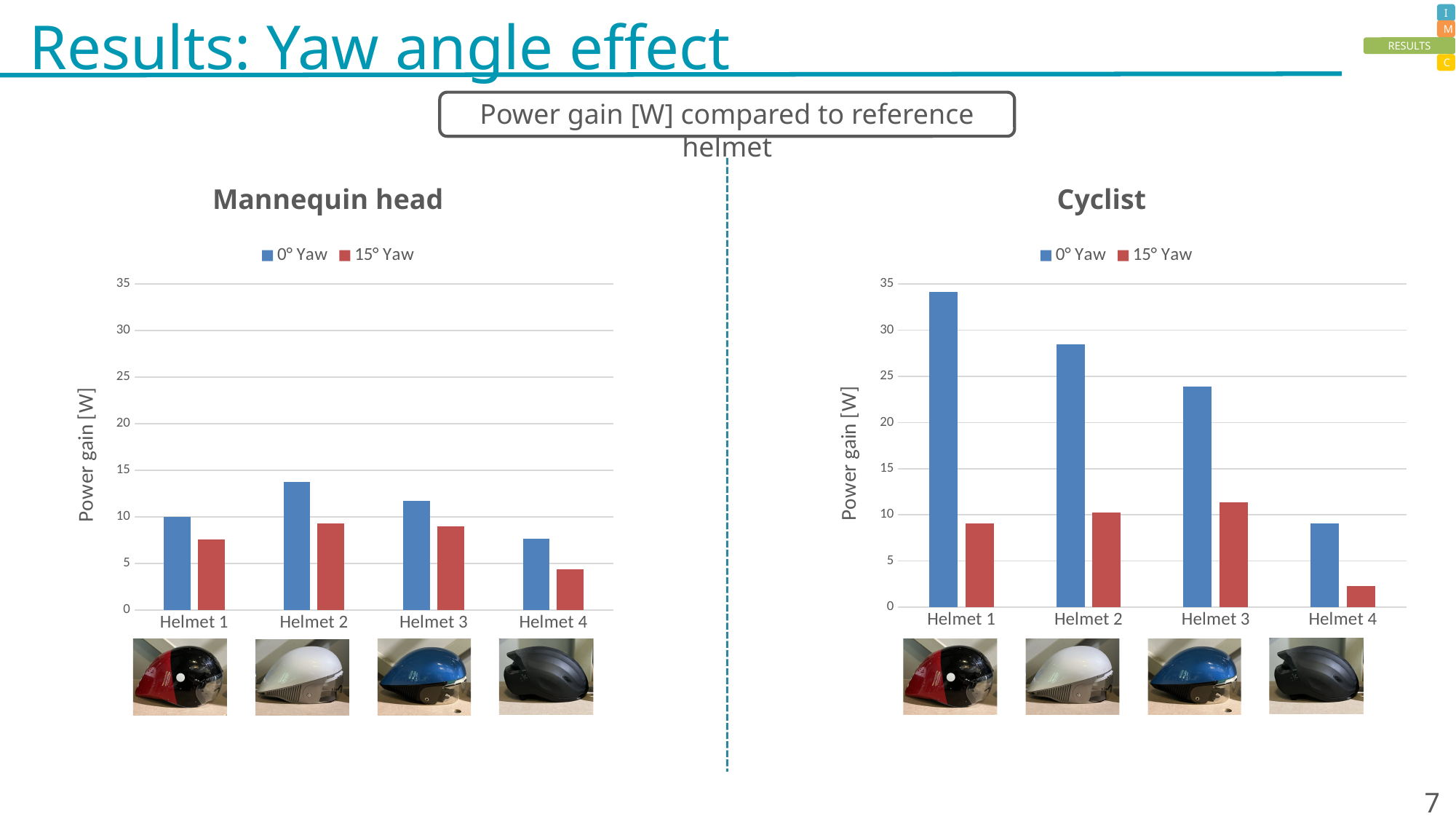
On the Cyclist chart, is the 0° Yaw value for Helmet 4 greater or less than 10? less On the Mannequin head chart, which helmet has the lowest 15° Yaw power gain? Helmet 4 How many series does the legend of the Mannequin head chart list? 2 On the Cyclist chart, which helmet has the highest 0° Yaw power gain? Helmet 1 On the Cyclist chart, is the 0° Yaw value for Helmet 1 greater or less than 30? greater How many helmet categories are shown on the Cyclist chart? 4 On the Mannequin head chart, which helmet has the highest 0° Yaw power gain? Helmet 2 On the Cyclist chart, which helmet has the lowest 15° Yaw power gain? Helmet 4 On the Mannequin head chart, is the 15° Yaw value for Helmet 4 greater or less than 5? less On the Cyclist chart, which is larger for Helmet 3: the 0° Yaw value or the 15° Yaw value? 0° Yaw What type of chart is the Cyclist chart? Bar chart On the Mannequin head chart, which is larger: the 0° Yaw value for Helmet 2 or the 0° Yaw value for Helmet 4? Helmet 2